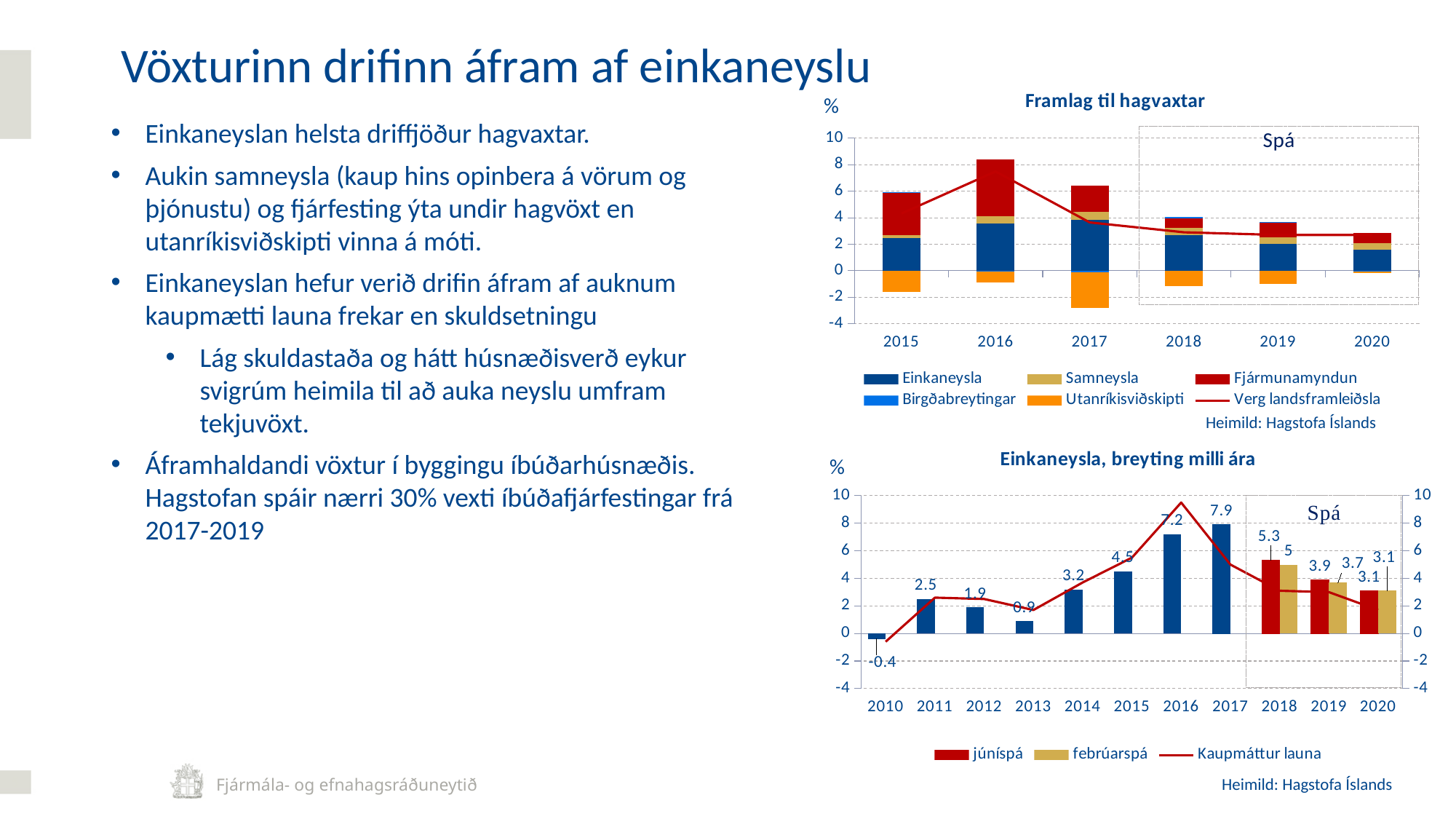
In the chart 'Einkaneysla, breyting milli ára', what is the júníspá value for 2018? 5.3 How many years are shown on the x axis of the chart 'Einkaneysla, breyting milli ára'? 11 In the chart 'Einkaneysla, breyting milli ára', what is the febrúarspá value for 2019? 3.7 In the chart 'Einkaneysla, breyting milli ára', what is the value for 2011? 2.5 How many series does the legend of the chart 'Framlag til hagvaxtar' list? 6 In the chart 'Einkaneysla, breyting milli ára', what is the difference between the values for 2017 and 2016? 0.7 What kind of chart is 'Framlag til hagvaxtar'? Stacked bar chart with a line In the chart 'Einkaneysla, breyting milli ára', which year has the lowest value? 2010 In the chart 'Einkaneysla, breyting milli ára', which is larger for 2018: júníspá or febrúarspá? júníspá In the chart 'Einkaneysla, breyting milli ára', what is the value for 2017? 7.9 In the chart 'Framlag til hagvaxtar', is the Utanríkisviðskipti value for 2017 greater or less than -2? less In the chart 'Einkaneysla, breyting milli ára', which year has the highest value? 2017